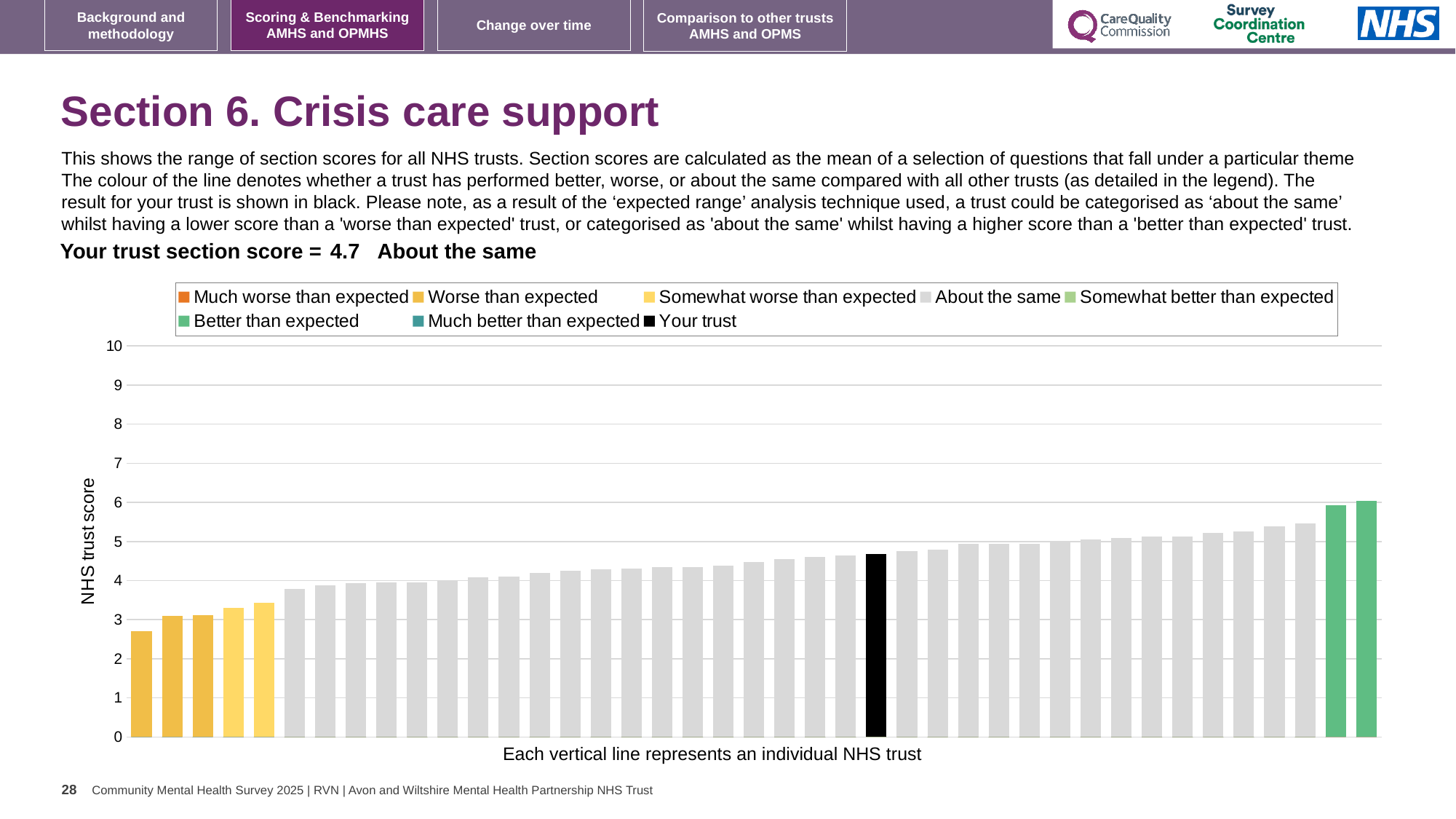
What is the label on the y axis of the chart? NHS trust score Do the bar values rise or fall from left to right along the x axis? rise Is the value of the highest bar in the chart greater or less than 5? greater How many entries does the chart legend list? 8 Which category is your trust placed in for this section? About the same Is the value of the highest bar in the chart greater or less than 7? less How many bars are coloured green (Better than expected)? 2 What is the section score for your trust shown on the slide? 4.7 What kind of chart is shown on the slide? bar chart What colour is used for the bar representing your trust? black Is the value of the lowest bar in the chart greater or less than 3? less